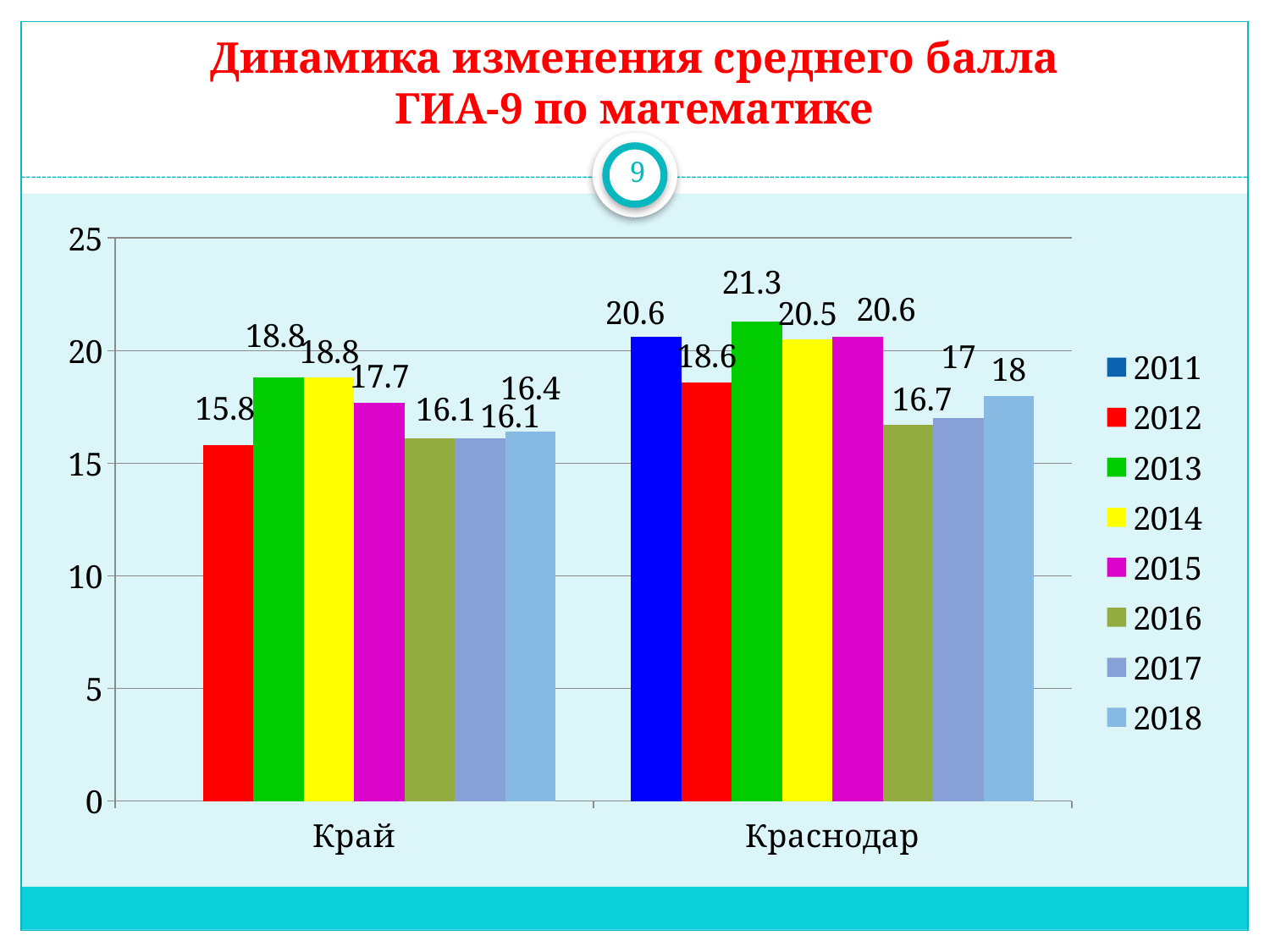
What is the title of the chart on the slide? Динамика изменения среднего балла ГИА-9 по математике What kind of chart is shown on the slide? bar chart Which year has the lowest value in the Край category? 2012 Which is larger: the 2016 value for Край or the 2016 value for Краснодар? Краснодар What is the value for 2013 in the Краснодар category? 21.3 Is the value for 2011 in the Краснодар category greater or less than 20? greater Which year has the highest value in the Краснодар category? 2013 What is the value for 2018 in the Краснодар category? 18 How many series does the legend list? 8 What is the value for 2012 in the Край category? 15.8 What is the difference between the 2013 value for Краснодар and the 2013 value for Край? 2.5 How many categories are shown on the x axis? 2